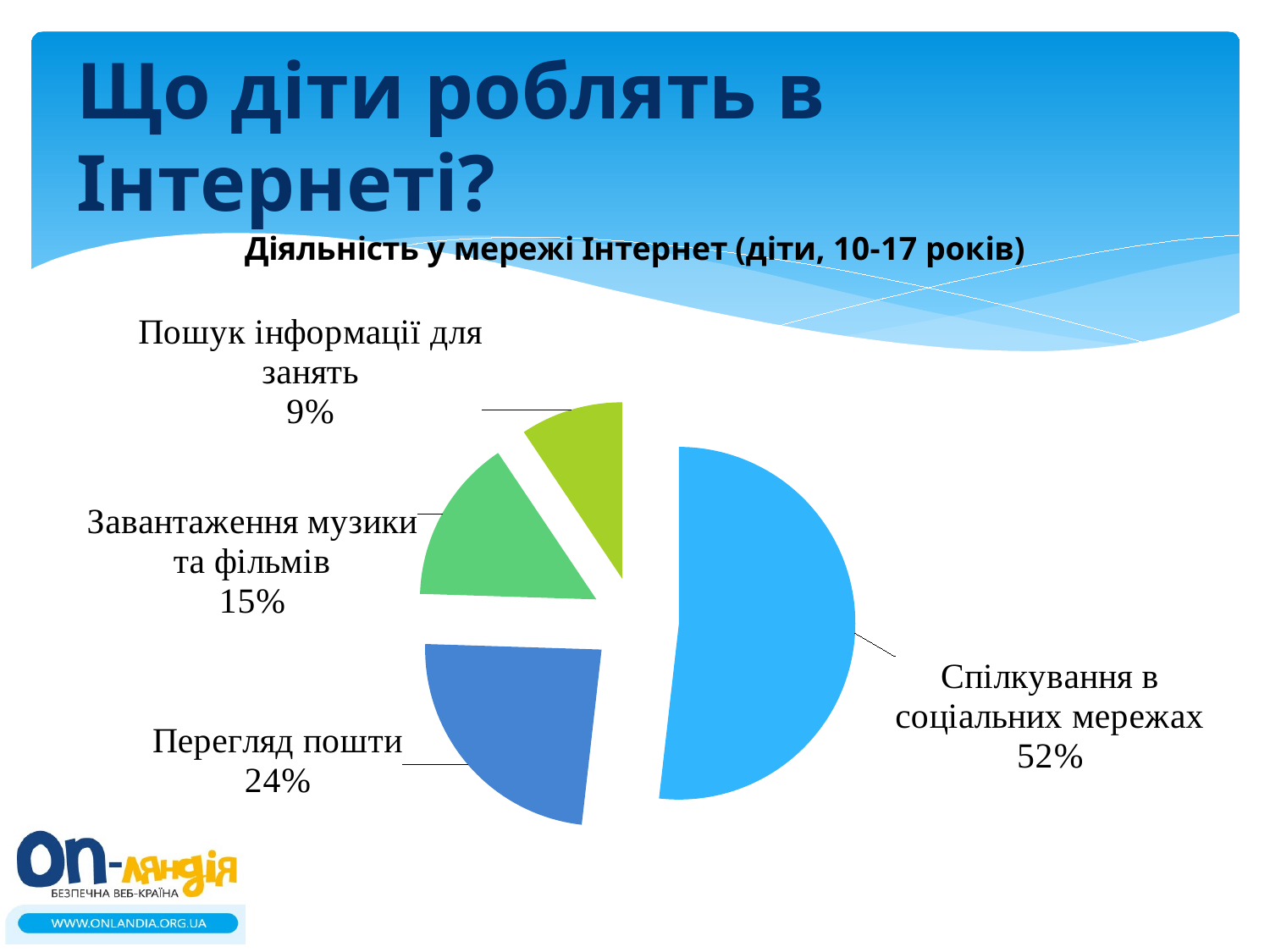
How many categories are shown in the pie chart? 4 What is the value for 'Пошук інформації для занять'? 9% What is the chart's title? Діяльність у мережі Інтернет (діти, 10-17 років) What is the value for 'Завантаження музики та фільмів'? 15% Which is larger, 'Завантаження музики та фільмів' or 'Пошук інформації для занять'? Завантаження музики та фільмів What is the value for 'Перегляд пошти'? 24% What share of the pie is 'Спілкування в соціальних мережах'? 52% What colour is the slice for 'Пошук інформації для занять'? green (yellow-green) What kind of chart is shown on the slide? pie chart What is the difference between 'Спілкування в соціальних мережах' and 'Перегляд пошти'? 28% Which category has the smallest slice? Пошук інформації для занять Which category has the largest slice? Спілкування в соціальних мережах